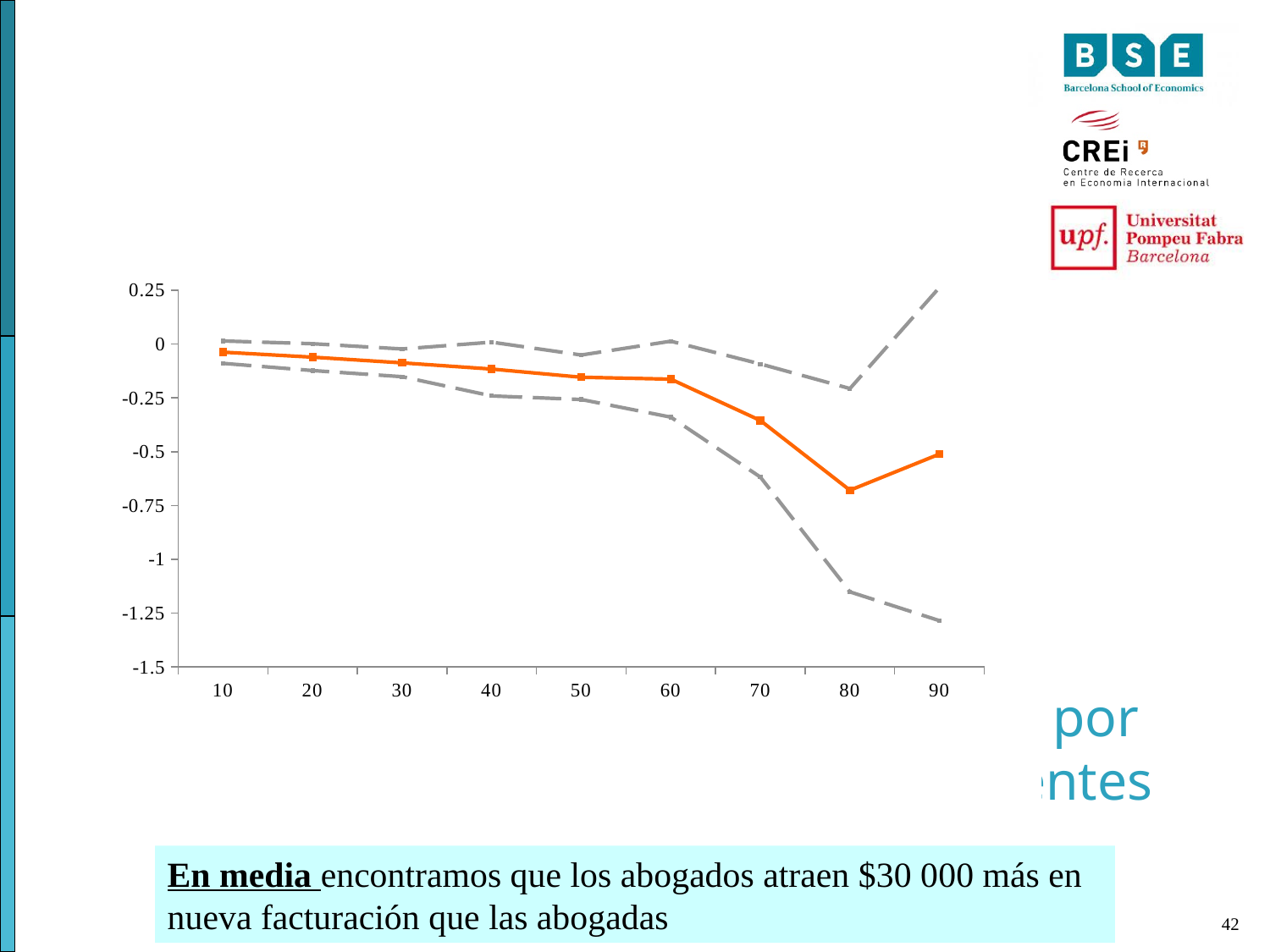
Is the value of the solid orange line at 90 greater or less than -0.75? greater What kind of chart is shown on the slide? line chart How many points are labelled on the x axis of the chart? 9 Is the value of the solid orange line at 10 greater or less than -0.25? greater Is the value of the solid orange line at 80 greater or less than -0.5? less On the solid orange line, which is larger: the value at 70 or the value at 80? 70 At which x-axis value does the solid orange line reach its lowest point? 80 What colour is the solid line with square markers? orange What is the lowest tick value shown on the y axis? -1.5 How many lines are plotted on the chart? 3 Does the solid orange line rise or fall from 10 to 80 on the x axis? fall